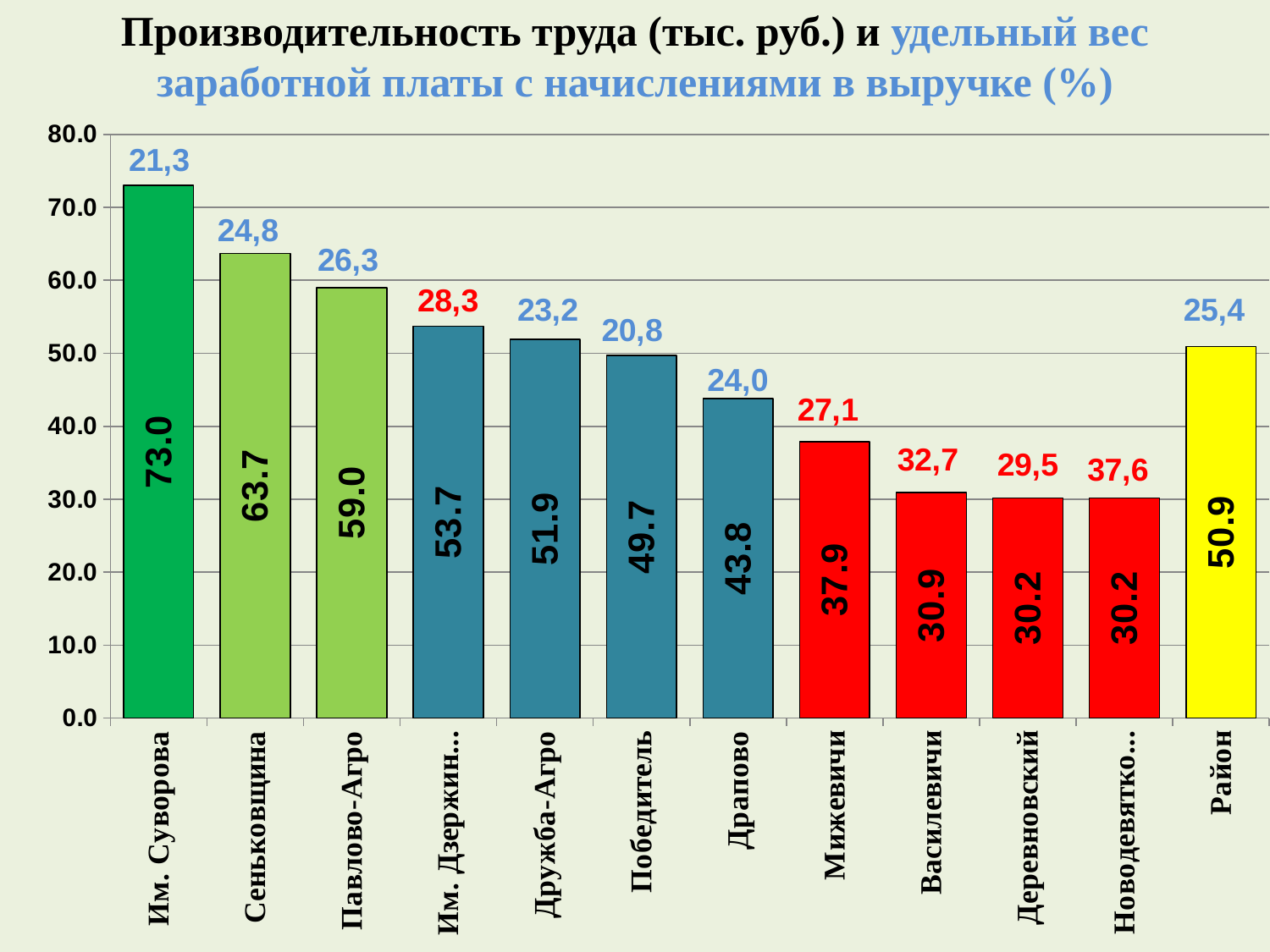
Which category has the highest labour productivity bar? Им. Суворова Is the labour productivity value for Драпово greater or less than 40? greater What is the difference in labour productivity between Им. Суворова and Драпово? 29.2 What kind of chart is shown on the slide? bar chart What colour is the bar for Район? yellow What is the labour productivity value (тыс. руб.) shown for Сеньковщина? 63.7 What is the difference between the wage share labels of Василевичи and Мижевичи? 5,6 How many bars are shown in the chart? 12 Which has the higher labour productivity, Мижевичи or Василевичи? Мижевичи What is the wage share (%) label shown above the bar for Победитель? 20,8 What is the labour productivity value shown for Район? 50.9 Which category has the lowest wage share (%) label? Победитель